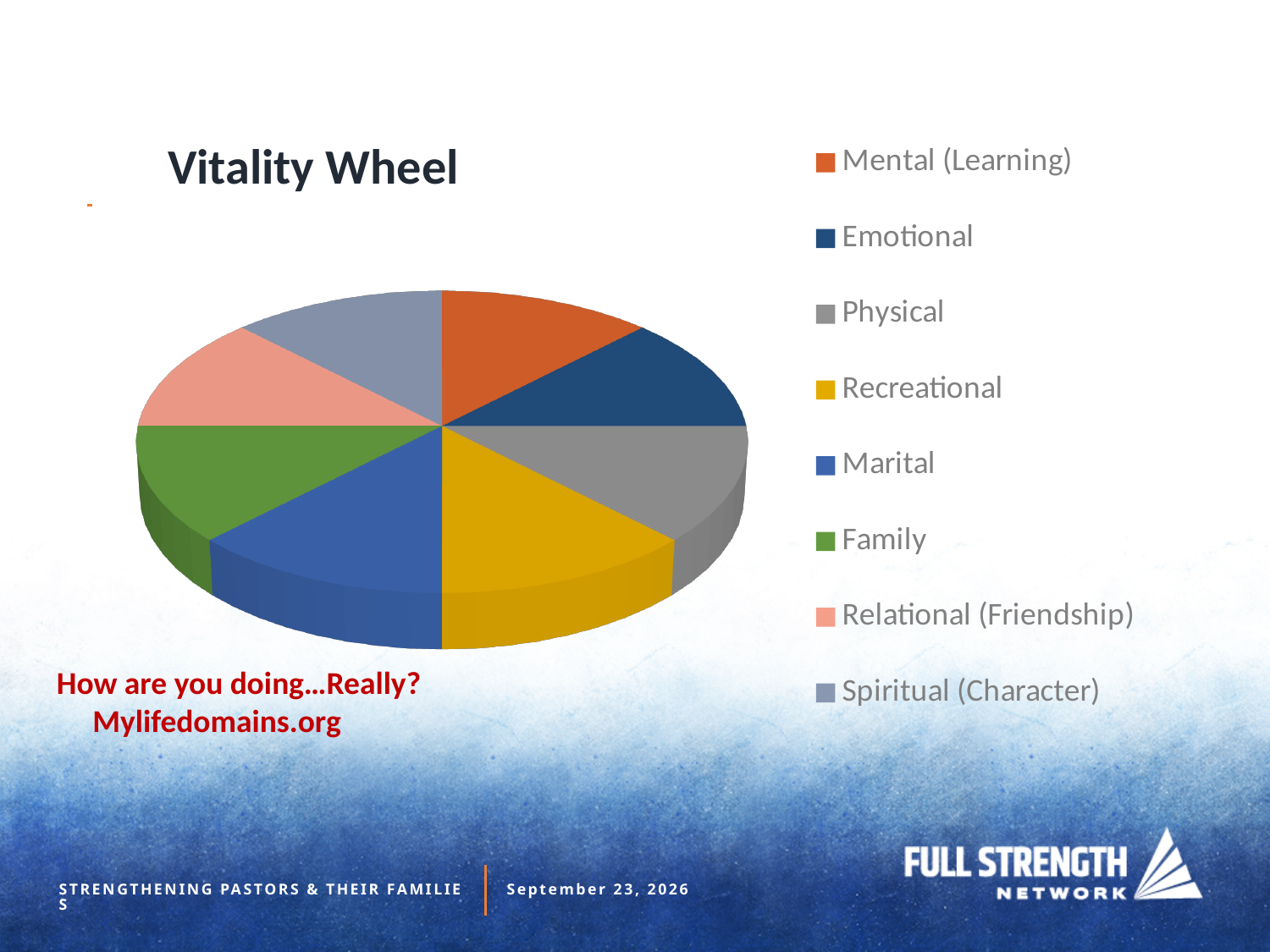
How many entries does the legend of the pie chart list? 8 What is the title of the pie chart? Vitality Wheel Is the Emotional slice larger than, smaller than, or the same size as the Physical slice? the same size What colour is the Mental (Learning) slice in the pie chart? orange What kind of chart is shown on the slide? pie chart Is the Family slice larger than, smaller than, or the same size as the Marital slice? the same size How many slices does the pie chart have? 8